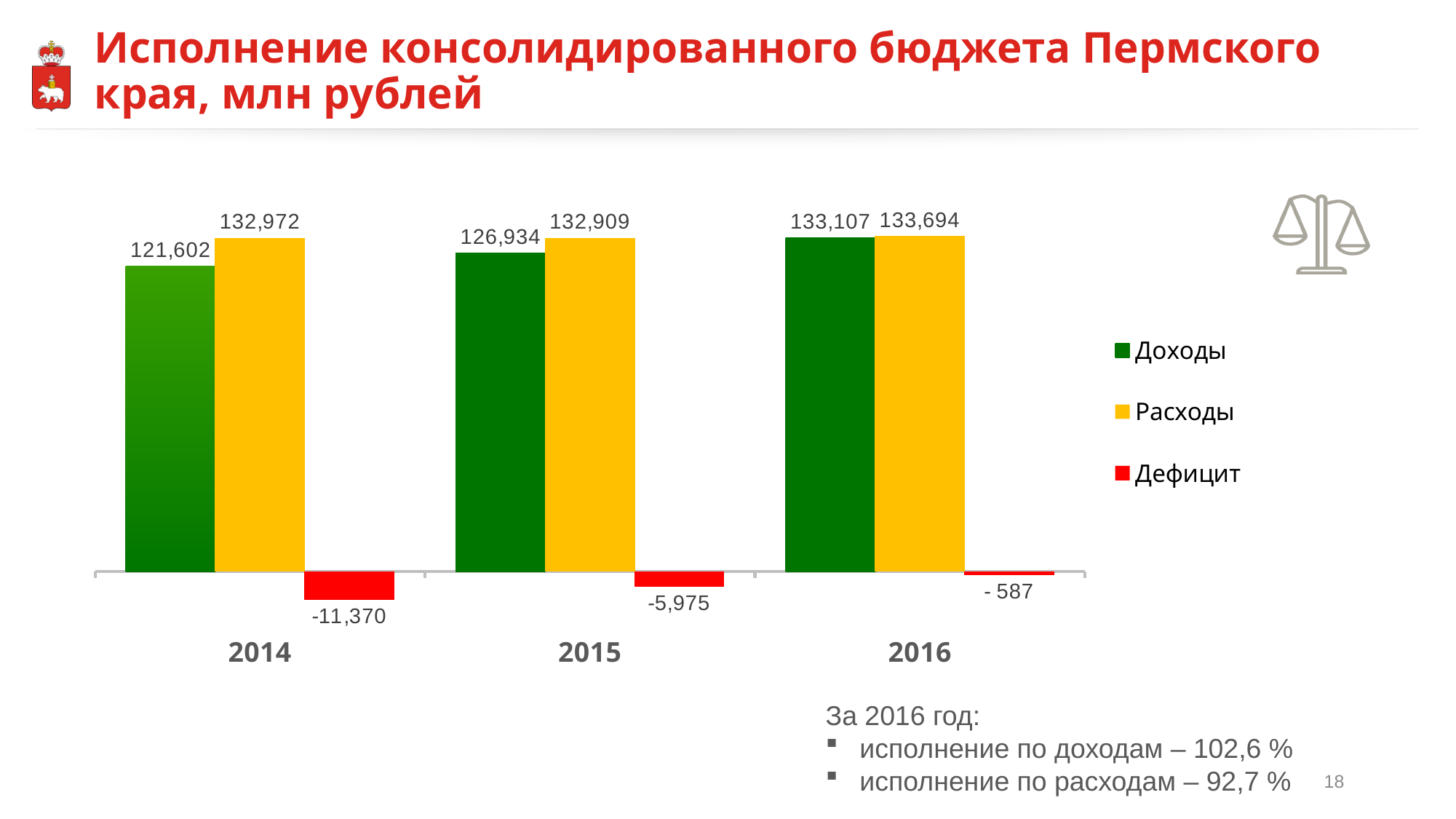
Which is larger in 2016, Доходы or Расходы? Расходы How many series does the legend list? 3 What is the value of Доходы for 2014? 121,602 What is the value of Дефицит for 2016? - 587 What is the value of Расходы for 2016? 133,694 In which year is Доходы the highest? 2016 What is the difference between Расходы and Доходы in 2014? 11,370 Do the Доходы values rise or fall from 2014 to 2016? rise What is the value of Расходы for 2015? 132,909 In which year is Доходы the lowest? 2014 How many years are shown on the x axis? 3 By how much did Доходы increase from 2015 to 2016? 6,173